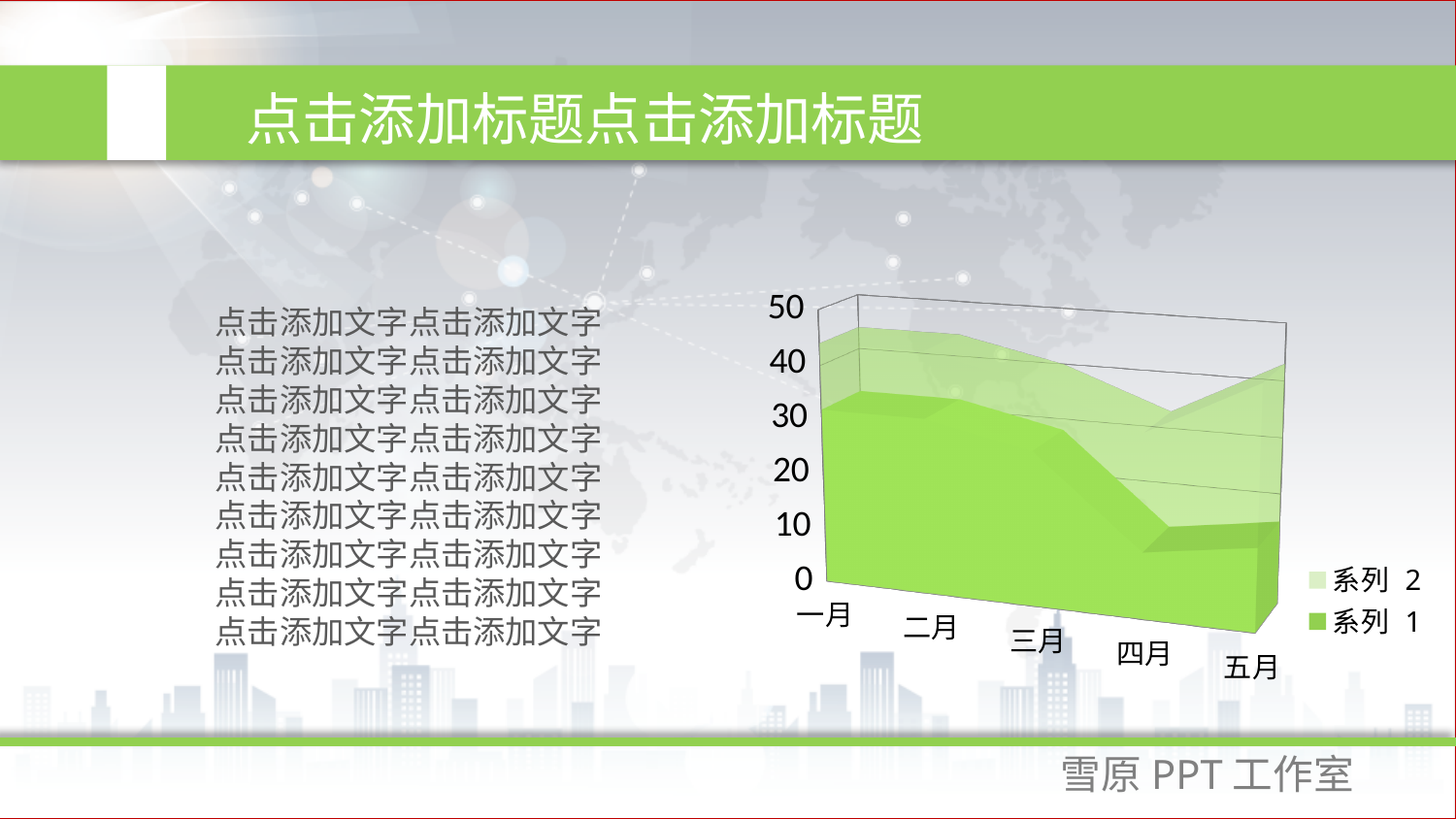
Is the value of 系列 1 for 三月 greater or less than 20? greater Is the value of 系列 1 for 一月 greater or less than 20? greater What kind of chart is shown on the slide? area chart Is the value of 系列 1 for 四月 greater or less than 20? less For 系列 1, which is larger: the value for 一月 or the value for 四月? 一月 How many categories are shown on the x axis of the chart? 5 Does the value of 系列 1 rise or fall from 三月 to 四月? fall What are the names of the series listed in the chart's legend? 系列 1 and 系列 2 How many series does the chart's legend list? 2 What is the first category on the x axis of the chart? 一月